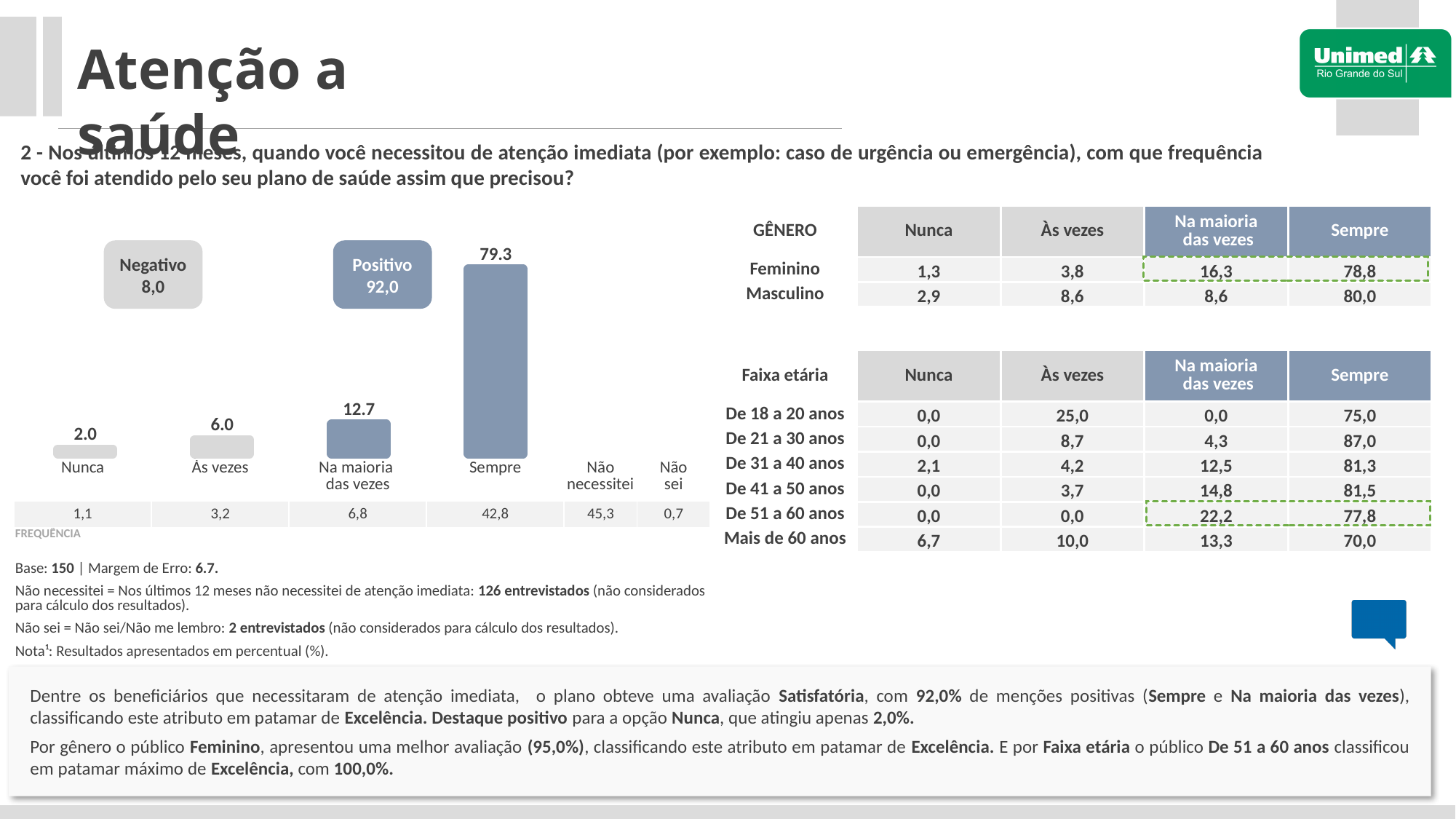
Which category has the highest bar in the bar chart? Sempre What is the value of the bar for Na maioria das vezes in the bar chart? 12.7 What is the difference between the bar values for Sempre and Na maioria das vezes? 66.6 What type of chart is shown on the slide? Bar chart Which bar is larger, Às vezes or Na maioria das vezes? Na maioria das vezes What is the difference between the bar values for Às vezes and Nunca? 4.0 What value is shown in the 'Positivo' box above the bar chart? 92,0 What is the value of the bar for Às vezes in the bar chart? 6.0 What is the value of the bar for Sempre in the bar chart? 79.3 Which category has the lowest bar in the bar chart? Nunca What is the value of the bar for Nunca in the bar chart? 2.0 Do the bar values rise or fall from Nunca to Sempre along the x axis? Rise